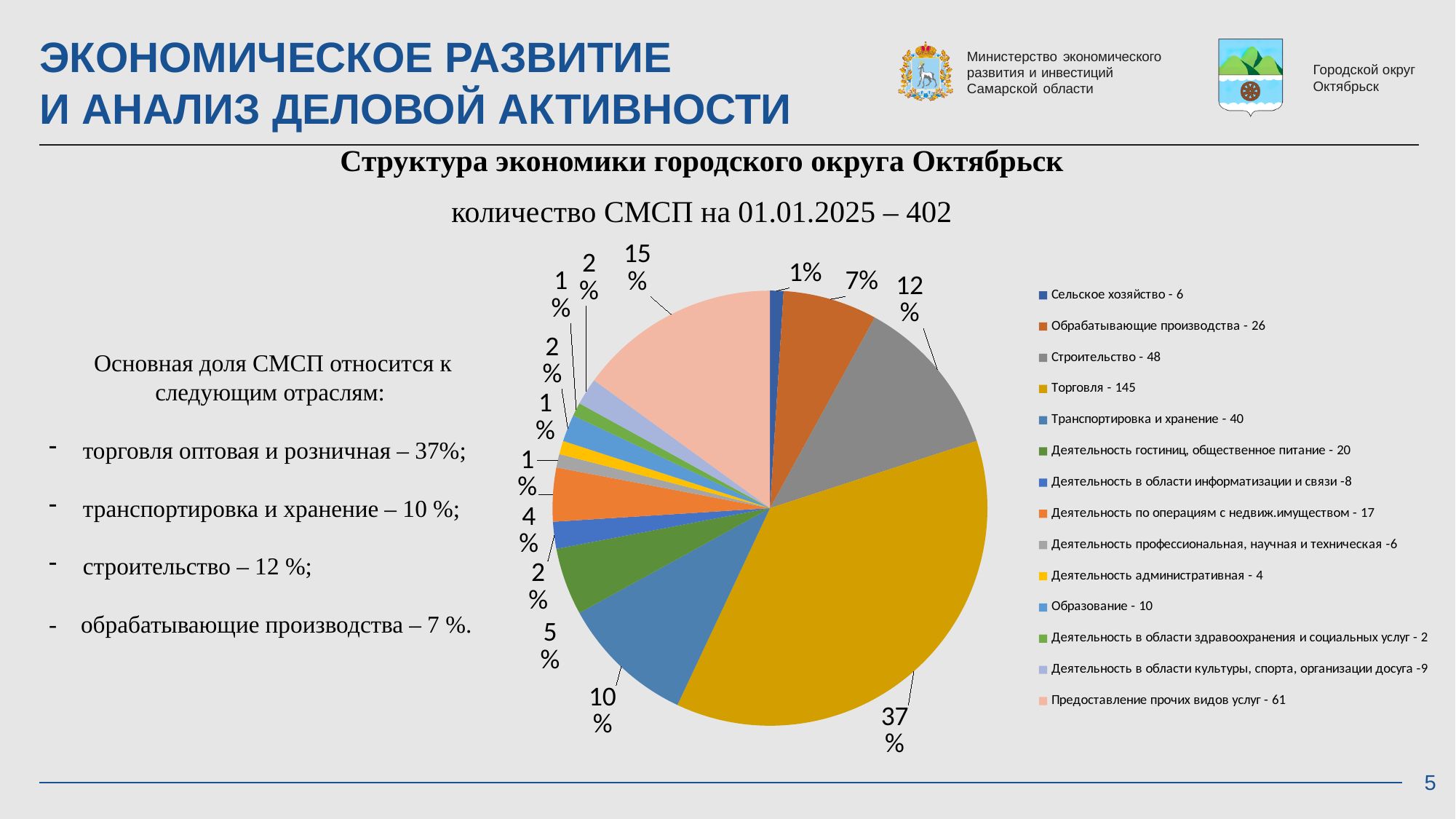
How many categories does the pie chart's legend list? 14 What share of the pie does Торговля account for? 37% What count is shown in the legend for Транспортировка и хранение? 40 Which category has the largest share of the pie? Торговля Which has a larger share of the pie, Транспортировка и хранение or Деятельность гостиниц, общественное питание? Транспортировка и хранение What is the title of the chart? Структура экономики городского округа Октябрьск What count is shown in the legend for Обрабатывающие производства? 26 What kind of chart is shown on the slide? pie chart What is the difference between the counts for Торговля and Строительство? 97 What share of the pie does Предоставление прочих видов услуг account for? 15% What share of the pie does Строительство account for? 12% Which category has the smallest count in the legend? Деятельность в области здравоохранения и социальных услуг